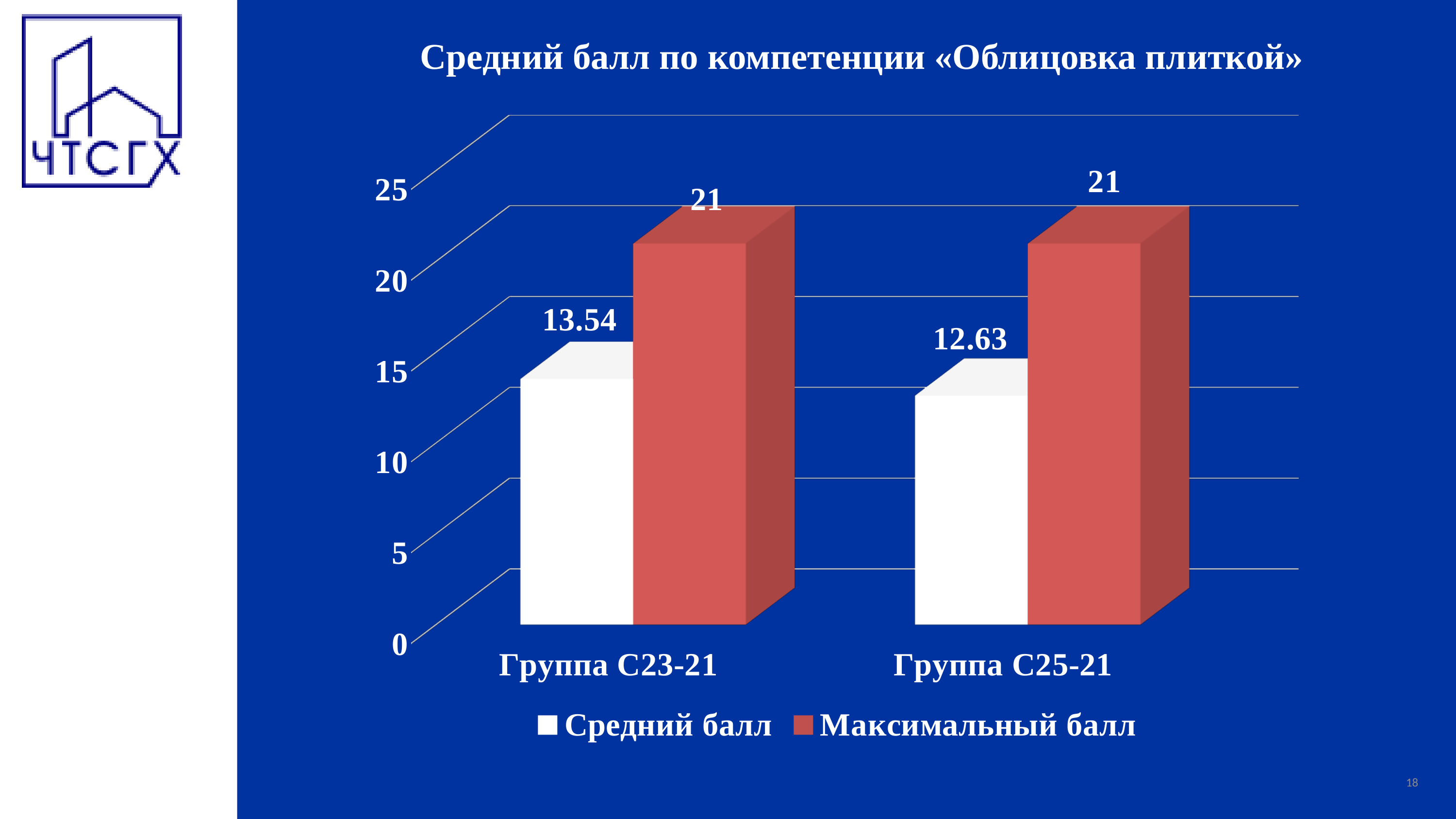
What is the title of the chart? Средний балл по компетенции «Облицовка плиткой» What is the Средний балл for Группа С25-21? 12.63 What is the Средний балл for Группа С23-21? 13.54 Which group has the higher Средний балл? Группа С23-21 What is the difference between the Максимальный балл and the Средний балл for Группа С25-21? 8.37 What is the difference between the Средний балл of Группа С23-21 and Группа С25-21? 0.91 Is the Средний балл for Группа С25-21 greater or less than 15? less What is the Максимальный балл for Группа С23-21? 21 How many series does the legend list? 2 How many groups are shown on the x axis? 2 What kind of chart is shown on the slide? bar chart Which group has the lower Средний балл? Группа С25-21